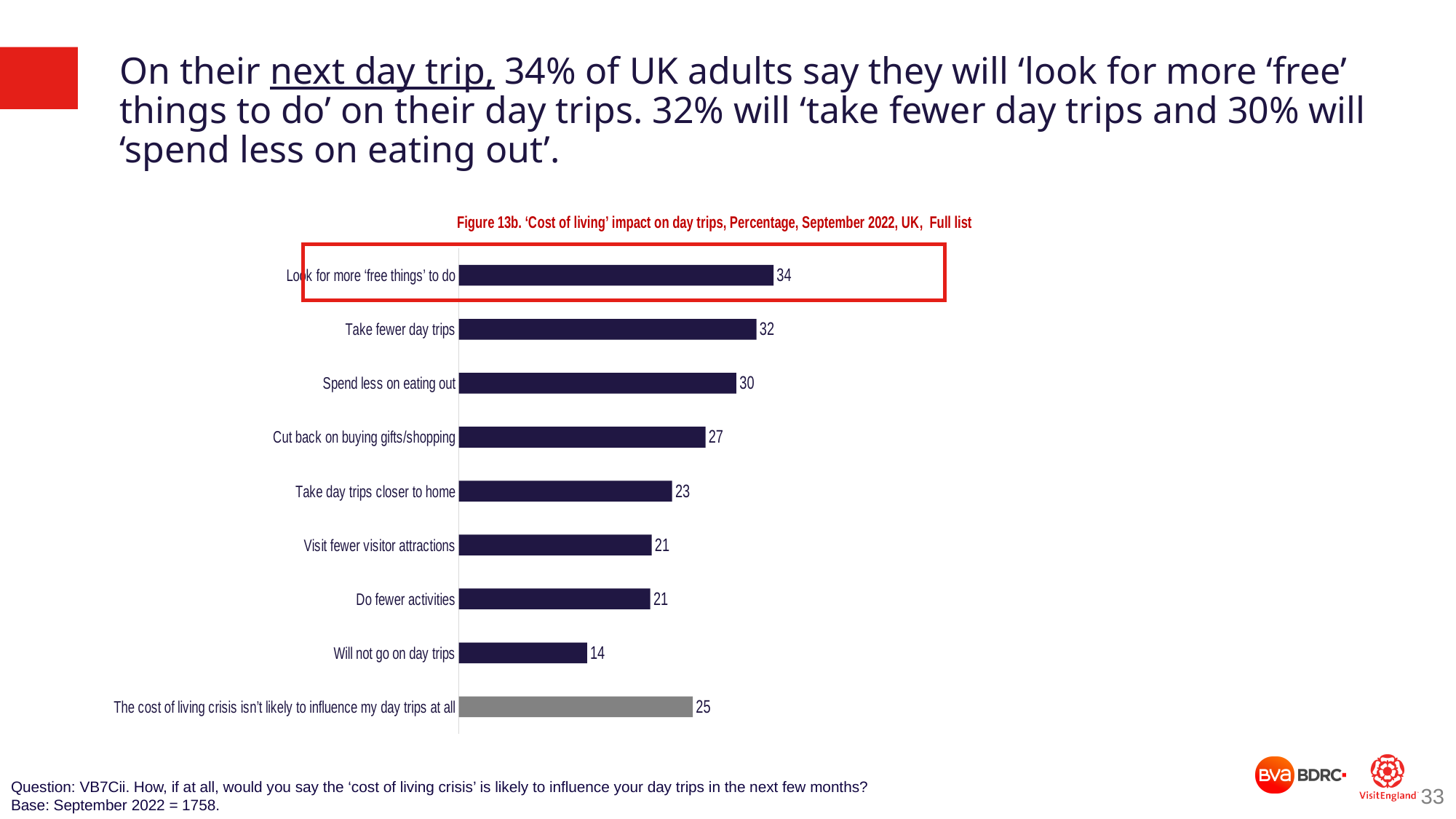
Which category has the lowest value? Will not go on day trips Which category has the highest value? Look for more ‘free things’ to do What is the value for 'Take day trips closer to home'? 23 What is the value for 'Look for more ‘free things’ to do'? 34 Which category's bar is coloured grey rather than dark navy? The cost of living crisis isn’t likely to influence my day trips at all What is the difference between 'Take fewer day trips' and 'Spend less on eating out'? 2 What is the value for 'The cost of living crisis isn’t likely to influence my day trips at all'? 25 What is the title of the chart? Figure 13b. ‘Cost of living’ impact on day trips, Percentage, September 2022, UK, Full list How many categories are shown in the chart? 9 What is the difference between 'Cut back on buying gifts/shopping' and 'Will not go on day trips'? 13 Which is larger, 'Spend less on eating out' or 'Take day trips closer to home'? Spend less on eating out What kind of chart is shown on the slide? Bar chart